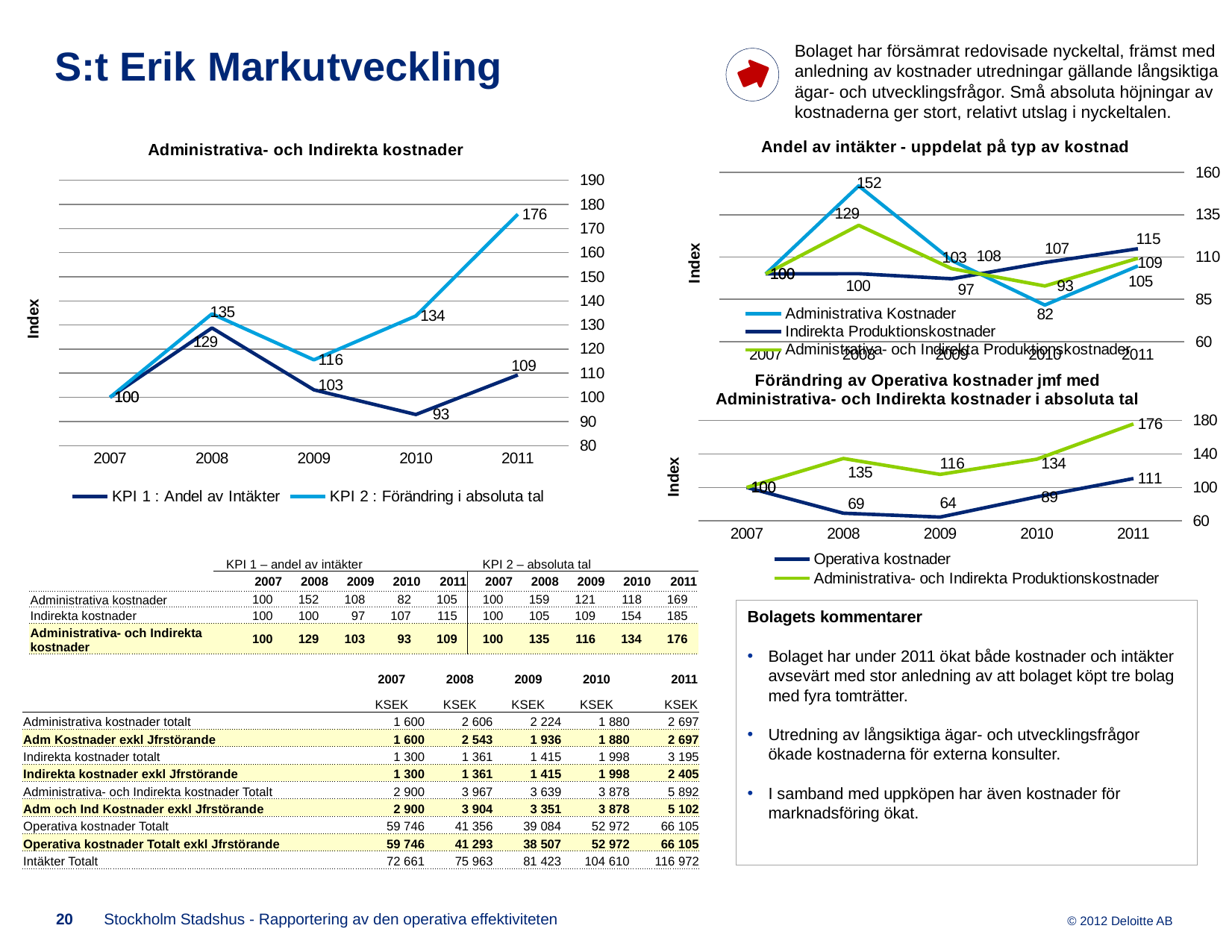
In the chart titled "Administrativa- och Indirekta kostnader", how many series does the legend list? 2 In the chart titled "Administrativa- och Indirekta kostnader", what is the value of KPI 1 : Andel av Intäkter in 2010? 93 In the chart titled "Administrativa- och Indirekta kostnader", what is the difference between KPI 2 and KPI 1 in 2011? 67 In the chart titled "Andel av intäkter - uppdelat på typ av kostnad", what is the value of Administrativa Kostnader in 2008? 152 In the chart titled "Andel av intäkter - uppdelat på typ av kostnad", what is the value of Administrativa Kostnader in 2010? 82 In the chart titled "Förändring av Operativa kostnader jmf med Administrativa- och Indirekta kostnader i absoluta tal", what is the value of Operativa kostnader in 2009? 64 In the chart titled "Administrativa- och Indirekta kostnader", what is the value of KPI 2 : Förändring i absoluta tal in 2011? 176 In the chart titled "Förändring av Operativa kostnader jmf med Administrativa- och Indirekta kostnader i absoluta tal", which series has the higher value in 2011? Administrativa- och Indirekta Produktionskostnader In the chart titled "Andel av intäkter - uppdelat på typ av kostnad", how many series does the legend list? 3 In the chart titled "Förändring av Operativa kostnader jmf med Administrativa- och Indirekta kostnader i absoluta tal", how many years are shown on the x axis? 5 In the chart titled "Administrativa- och Indirekta kostnader", in which year is KPI 1 : Andel av Intäkter lowest? 2010 In the chart titled "Administrativa- och Indirekta kostnader", what kind of chart is it? Line chart